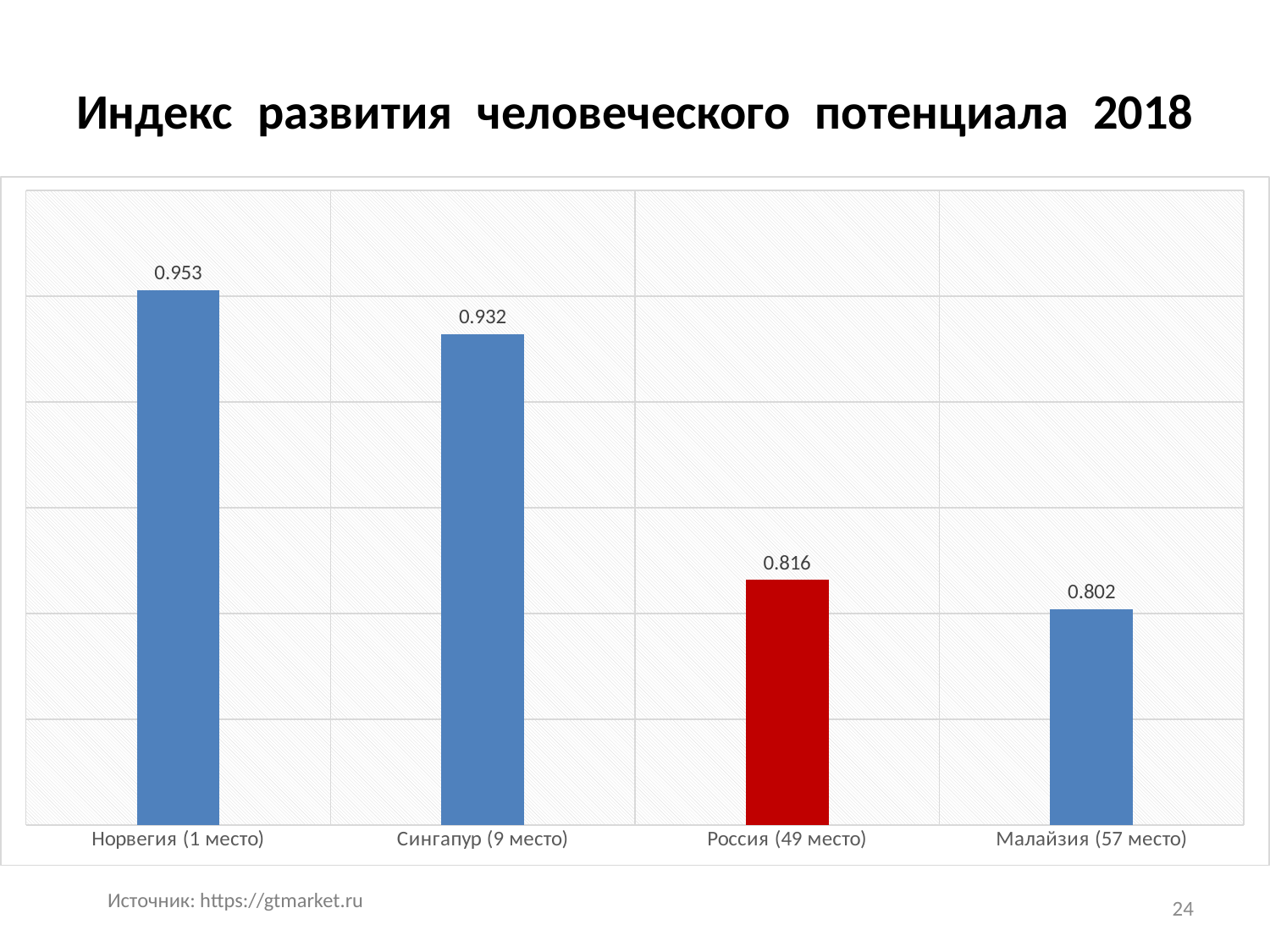
Which is larger, the value for Сингапур (9 место) or the value for Россия (49 место)? Сингапур (9 место) What is the value for Малайзия (57 место)? 0.802 What is the value for Сингапур (9 место)? 0.932 Which category's bar is coloured red? Россия (49 место) What kind of chart is shown on the slide? Bar chart What is the difference between the values for Сингапур (9 место) and Малайзия (57 место)? 0.130 What is the value for Россия (49 место)? 0.816 Which category has the highest value? Норвегия (1 место) What is the difference between the values for Норвегия (1 место) and Россия (49 место)? 0.137 How many categories are shown in the chart? 4 What is the value for Норвегия (1 место)? 0.953 Which category has the lowest value? Малайзия (57 место)